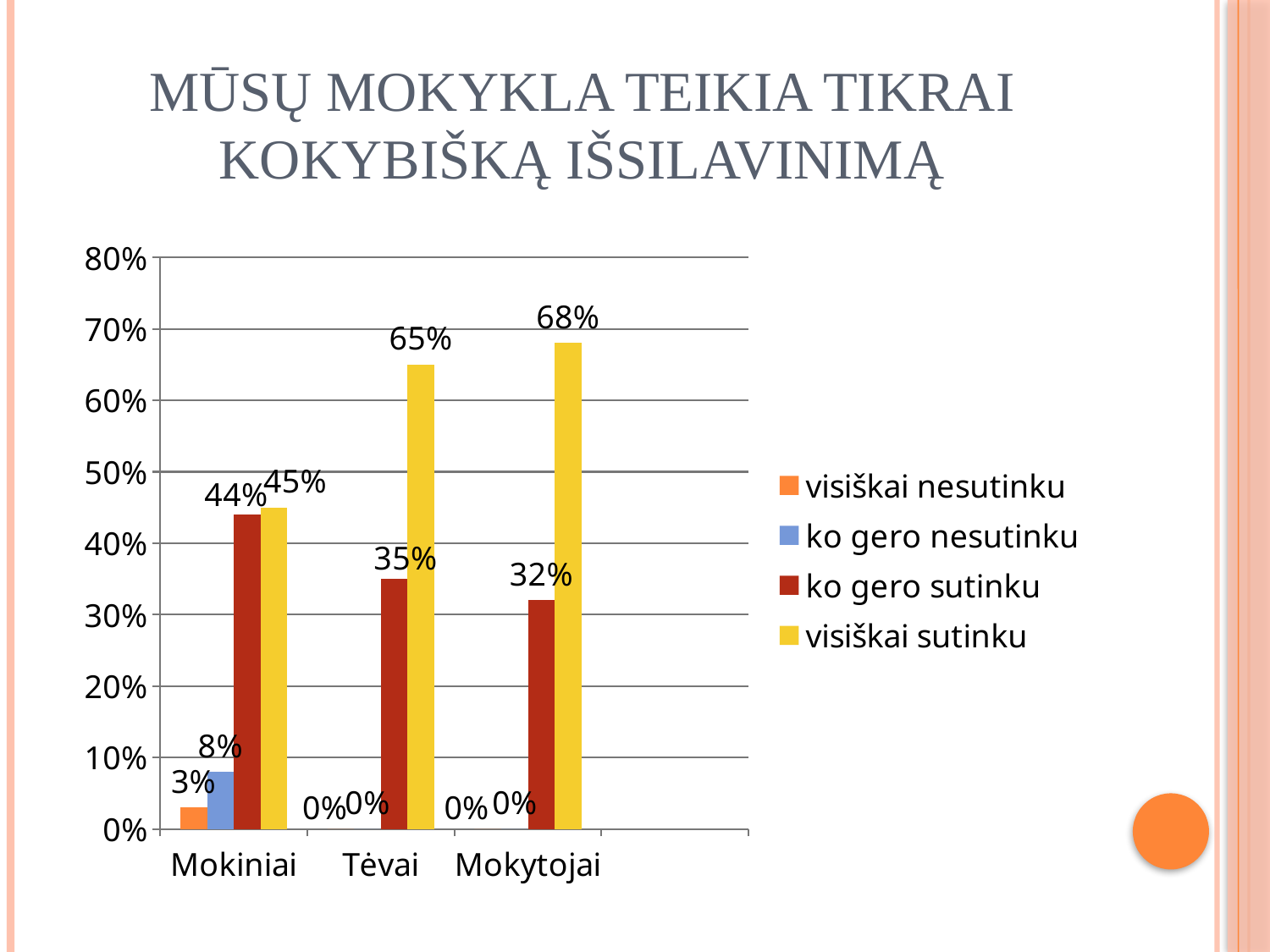
Which category has the highest value for 'visiškai sutinku'? Mokytojai What is the difference between the 'visiškai sutinku' values for Mokytojai and Tėvai? 3% What is the value for 'ko gero sutinku' for Tėvai? 35% What colour represents 'visiškai sutinku' in the legend? yellow How many series does the legend list? 4 What is the value for 'visiškai nesutinku' for Mokiniai? 3% What is the value for 'ko gero nesutinku' for Mokiniai? 8% Which category has the lowest value for 'ko gero sutinku'? Mokytojai What kind of chart is shown on the slide? bar chart Which is larger for Mokiniai: 'ko gero sutinku' or 'visiškai sutinku'? visiškai sutinku What is the value for 'visiškai sutinku' for Mokytojai? 68% How many categories are shown on the x axis? 3